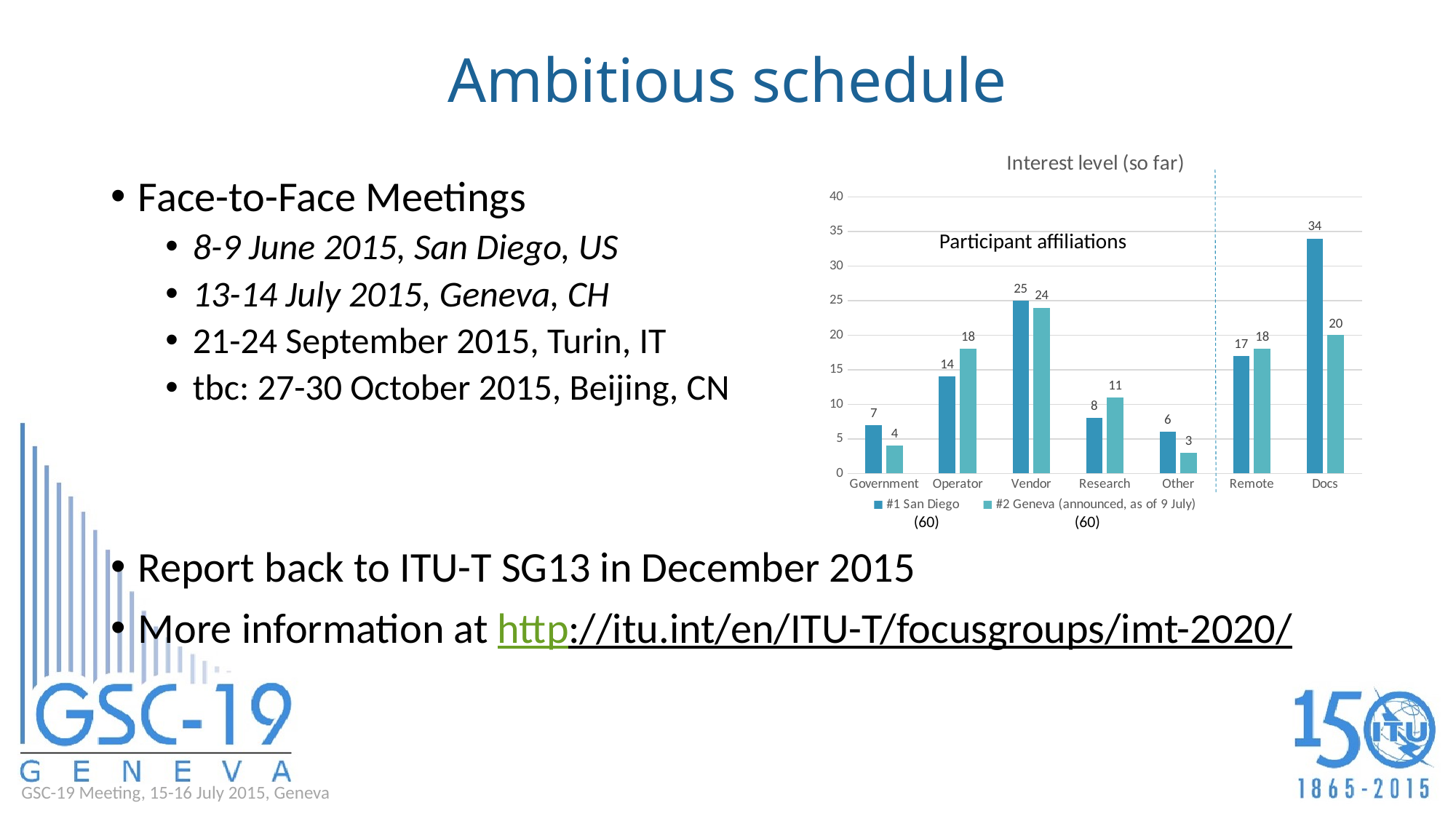
Which is larger for Research: the #1 San Diego value or the #2 Geneva value? #2 Geneva What is the value for Docs in the #2 Geneva (announced, as of 9 July) series? 20 What is the difference between the #2 Geneva and #1 San Diego values for Operator? 4 How many series does the legend list? 2 What kind of chart is shown on the slide? bar chart Which category has the lowest value in the #2 Geneva (announced, as of 9 July) series? Other How many categories are shown on the x axis? 7 What is the difference between the #1 San Diego and #2 Geneva values for Docs? 14 What is the value for Vendor in the #1 San Diego series? 25 What is the title of the chart? Interest level (so far) What is the value for Government in the #2 Geneva (announced, as of 9 July) series? 4 Which category has the highest value in the #1 San Diego series? Docs